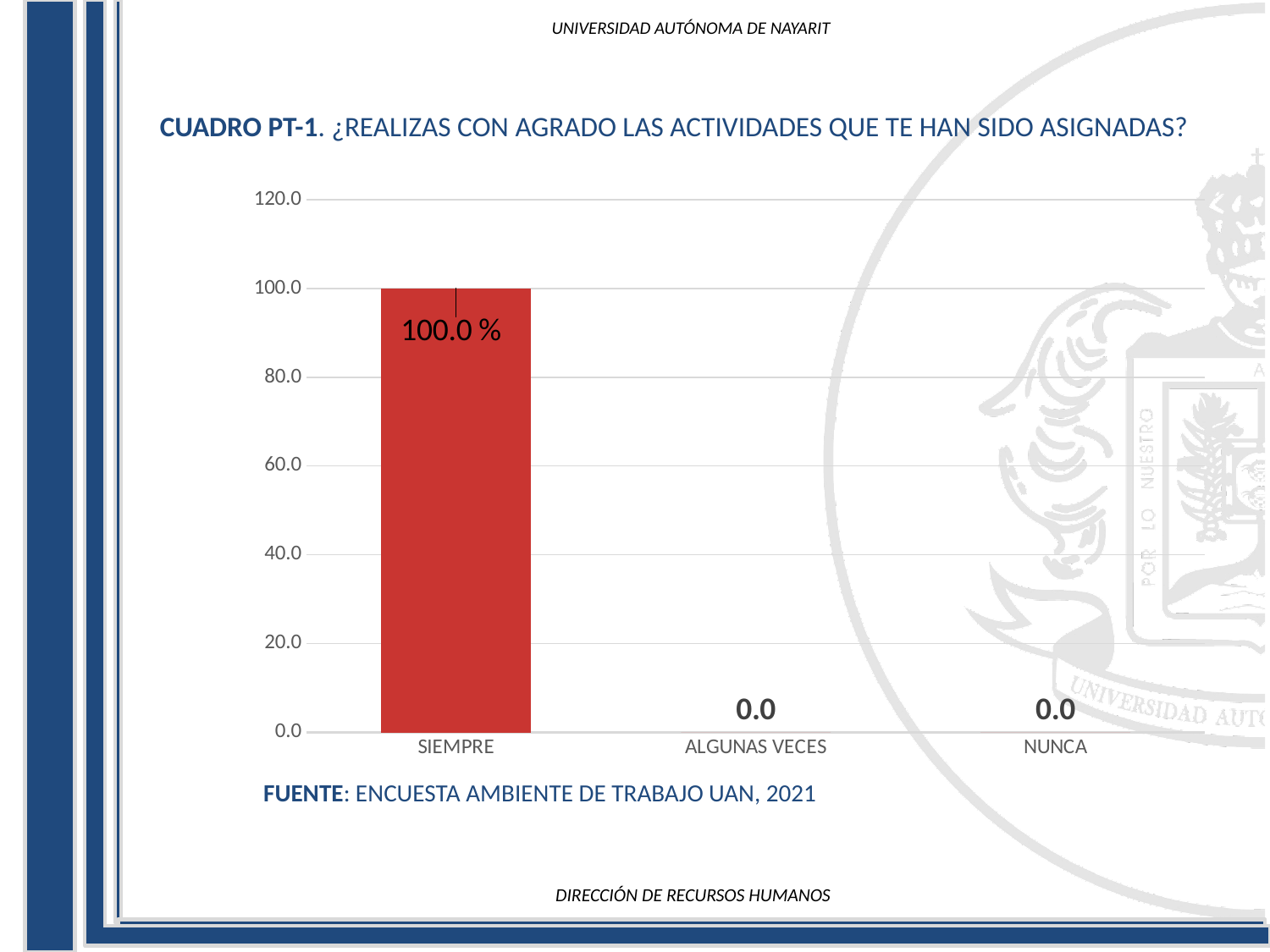
Is the value for SIEMPRE greater or less than 80.0? greater Which is larger, the value for SIEMPRE or the value for ALGUNAS VECES? SIEMPRE What is the value for ALGUNAS VECES? 0.0 How many categories are shown on the x axis? 3 Which category has the highest value? SIEMPRE What is the value for SIEMPRE? 100.0 % Do the values rise or fall from SIEMPRE to NUNCA along the x axis? fall What is the highest tick value shown on the y axis? 120.0 What is the difference between the values for SIEMPRE and NUNCA? 100.0 What kind of chart is shown on the slide? bar chart What is the value for NUNCA? 0.0 What colour is the bar for SIEMPRE? red